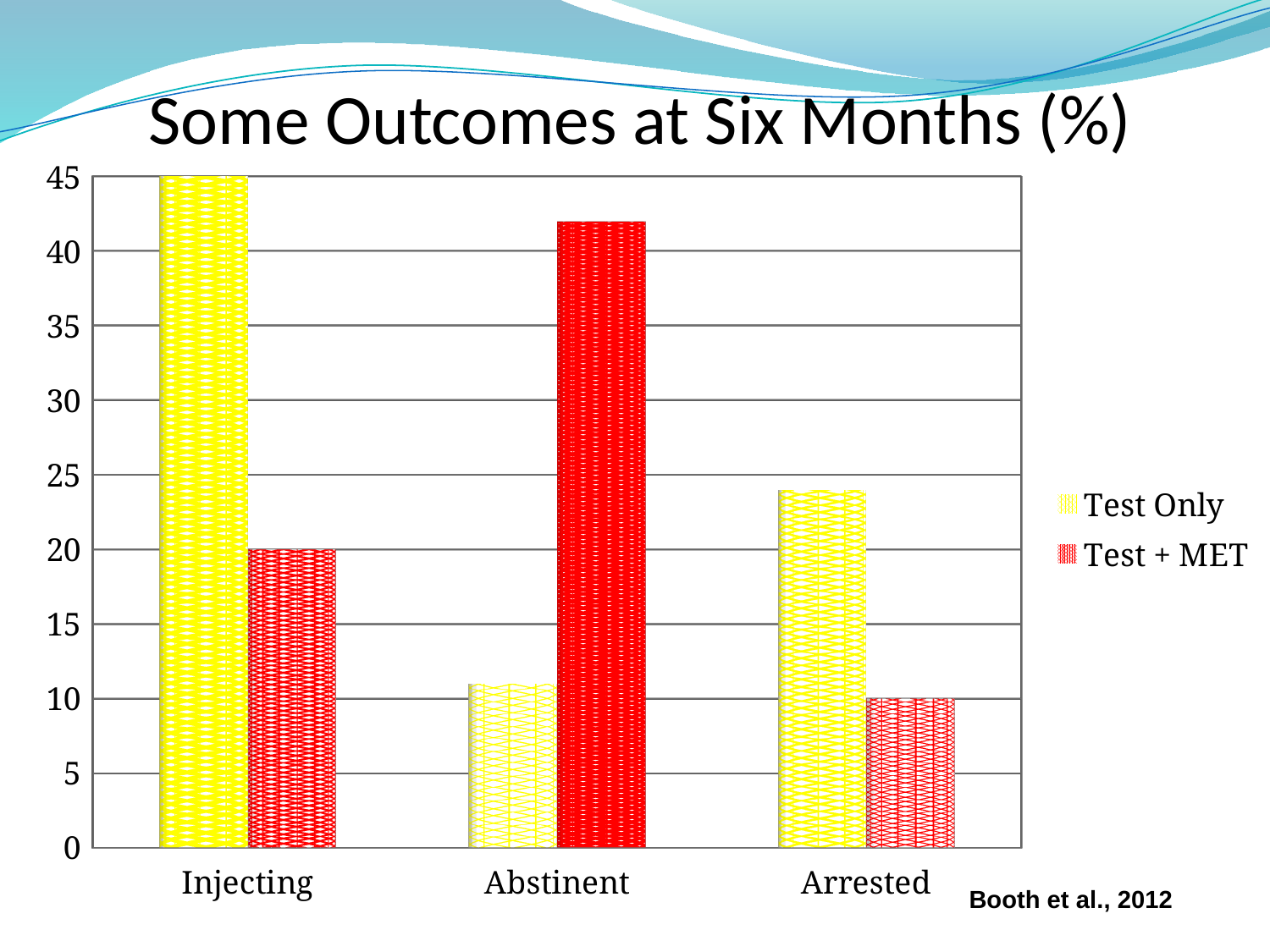
What is the Test + MET value for Injecting? 20 What type of chart is shown on the slide? bar chart What is the Test + MET value for Arrested? 10 How many outcome categories are shown on the x axis? 3 Which category has the highest Test + MET value? Abstinent For Abstinent, which is larger: Test Only or Test + MET? Test + MET Is the Test + MET value for Abstinent greater or less than 40? greater What is the Test Only value for Injecting? 45 What is the difference between the Test Only and Test + MET values for Injecting? 25 How many series does the legend list? 2 Which category has the lowest Test Only value? Abstinent